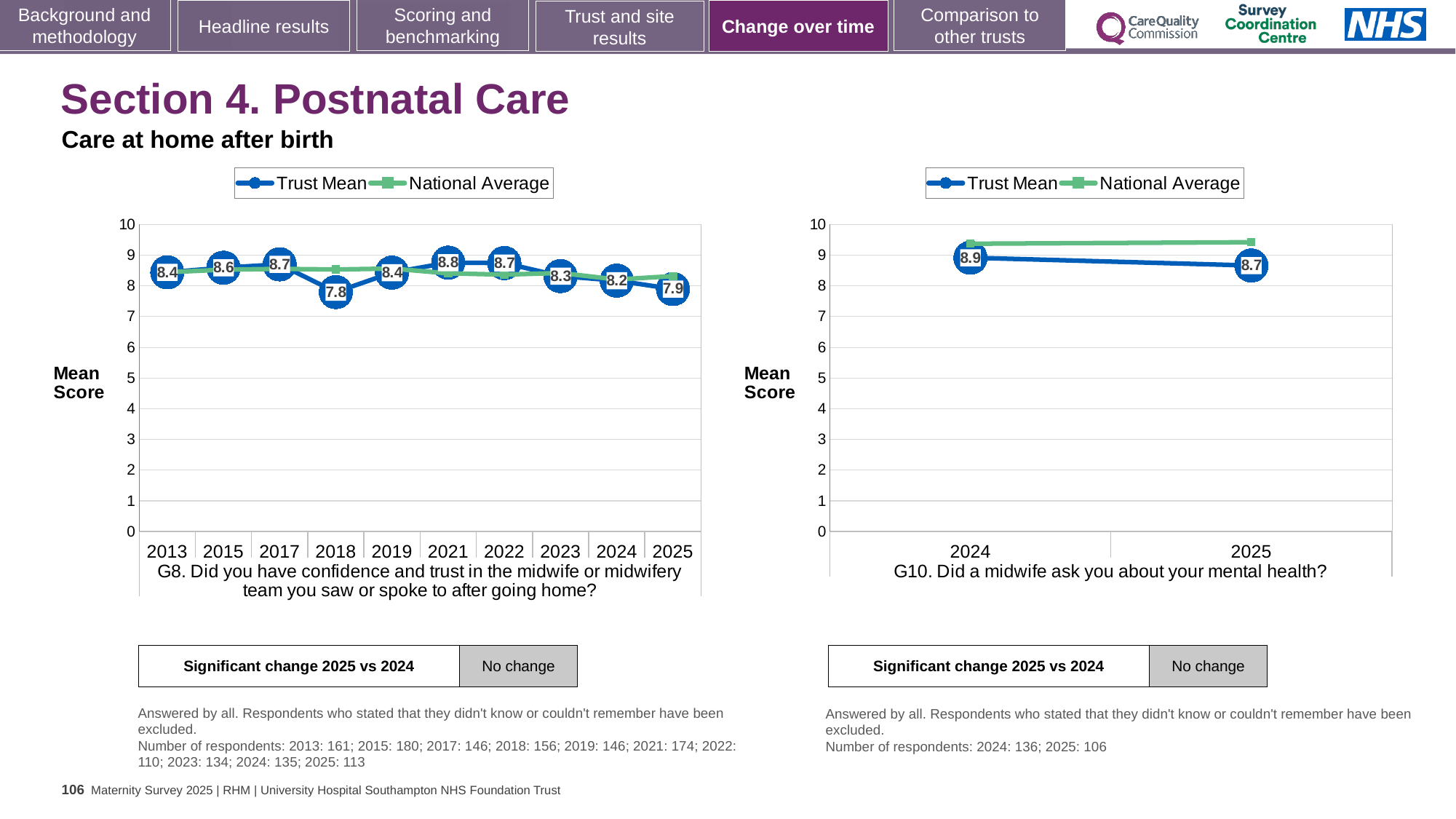
In the G10 chart, does the Trust Mean rise or fall from 2024 to 2025? fall In the G8 chart, which year has the lowest Trust Mean? 2018 What kind of chart is the G10 chart? line chart How many years are plotted on the x axis of the G8 chart? 10 In the G8 chart, which year has the highest Trust Mean? 2021 In the G8 chart, is the National Average for 2018 greater or less than 8? greater In the G8 chart, what is the Trust Mean for 2018? 7.8 In the G8 chart, what is the Trust Mean for 2021? 8.8 In the G8 chart, what is the difference between the Trust Mean in 2024 and in 2025? 0.3 In the G10 chart, what is the Trust Mean for 2024? 8.9 In the G8 chart, is the Trust Mean higher in 2015 or in 2023? 2015 How many series does the legend of the G10 chart list? 2